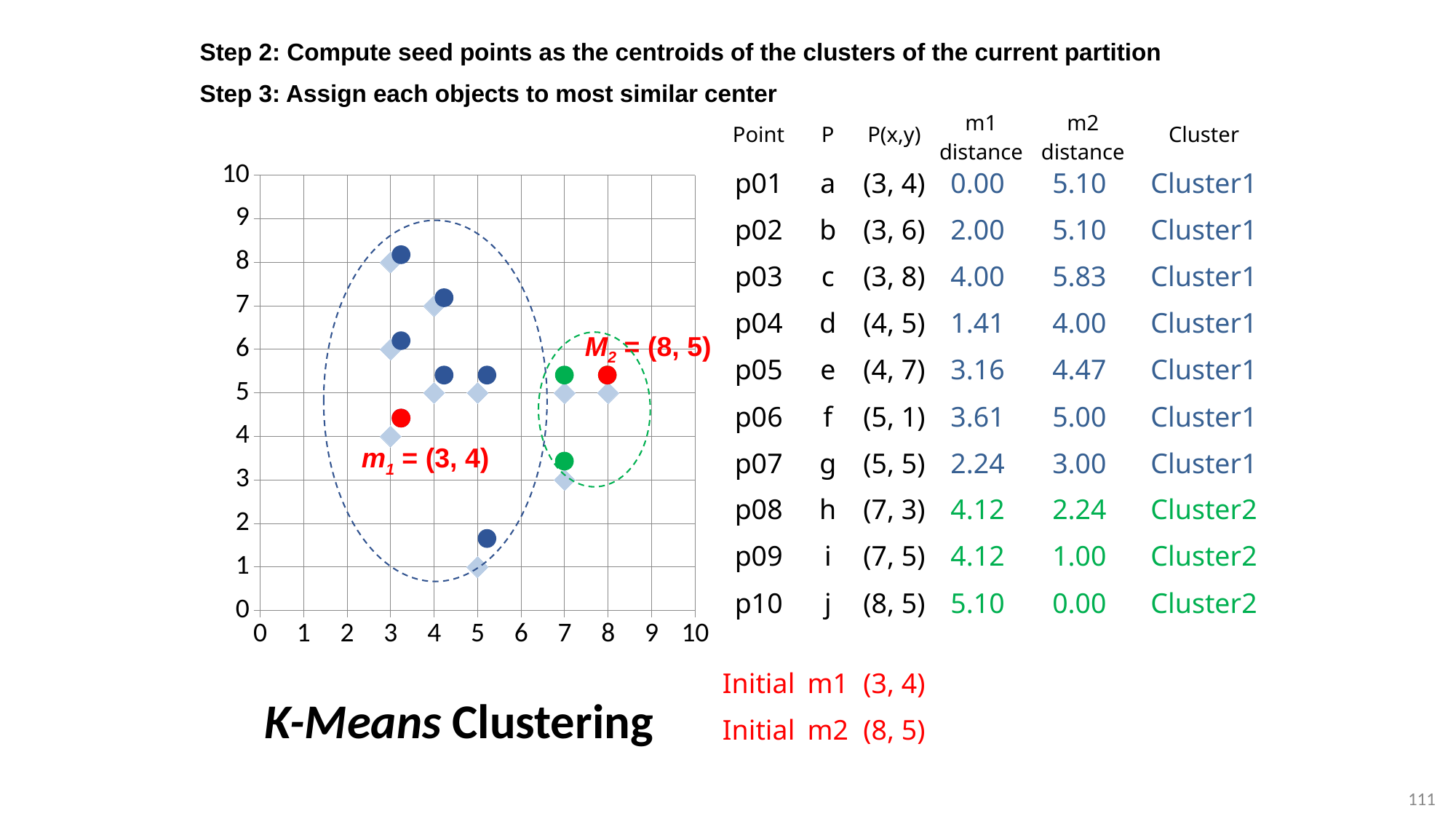
How many data points (diamond markers) are plotted on the chart? 10 What kind of chart is shown on the slide? scatter chart Which plotted point has the lowest y value? (5, 1) Which point has the larger y value, the one at (3, 8) or the one at (4, 7)? (3, 8) What is the difference in y value between the highest point (3, 8) and the lowest point (5, 1)? 7 What is the maximum value shown on the x axis of the chart? 10 What are the coordinates of the centroid labelled m1 on the chart? (3, 4) Which plotted point has the highest y value? (3, 8) How many data points lie inside the green dashed ellipse? 3 What are the coordinates of the centroid labelled M2 on the chart? (8, 5) Is the y value of the point at x = 3 with the highest y (point c) greater or less than 5? greater How many data points lie inside the blue dashed ellipse? 7